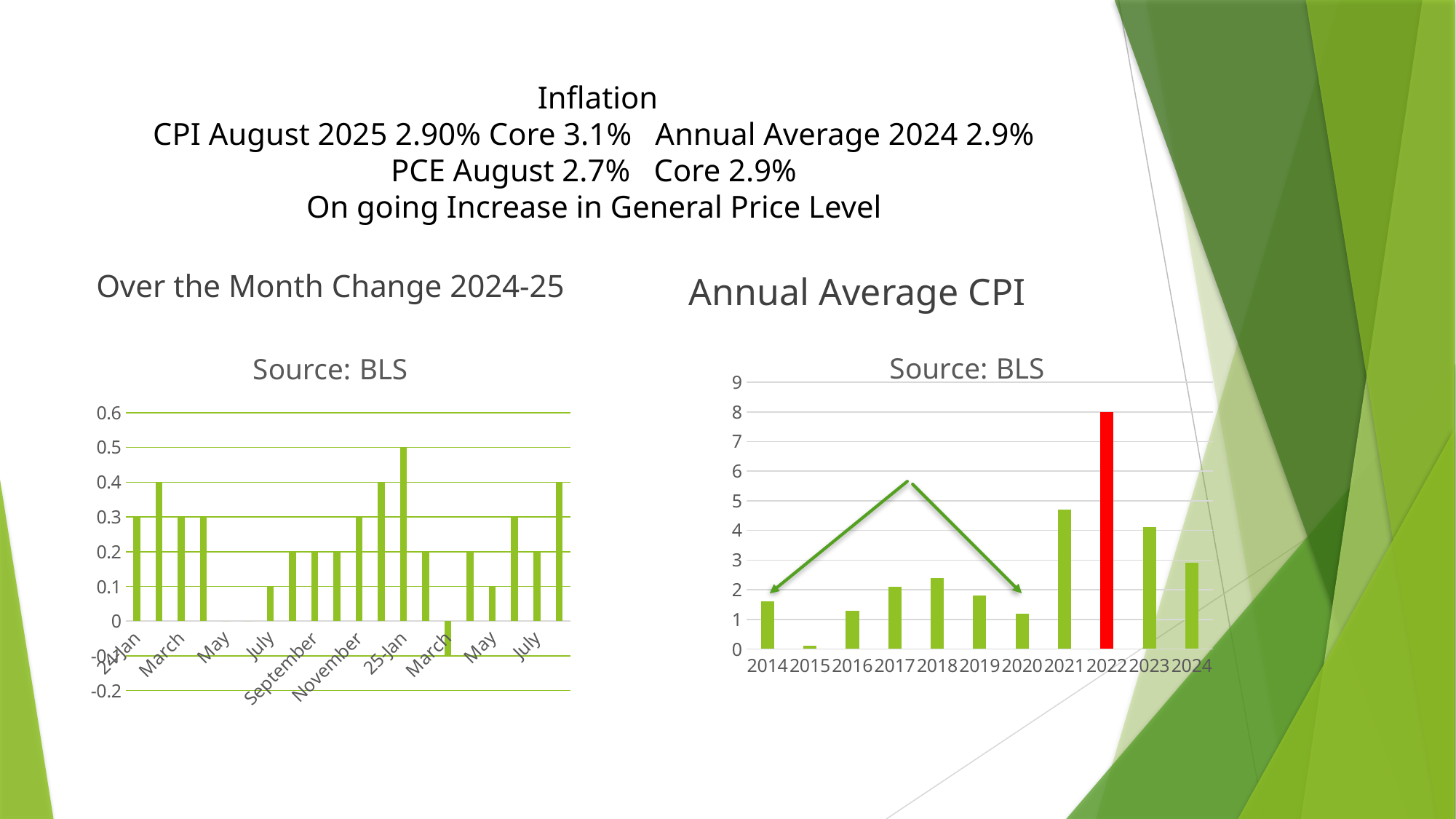
In the 'Over the Month Change 2024-25' chart, which month has the highest value? 25-Jan How many years are shown on the x axis of the 'Annual Average CPI' chart? 11 In the 'Annual Average CPI' chart, is the value for 2021 greater or less than 4? greater In the 'Annual Average CPI' chart, which bar is coloured red? 2022 In the 'Annual Average CPI' chart, which year has the highest value? 2022 In the 'Over the Month Change 2024-25' chart, what is the value for 25-Jan? 0.5 In the 'Annual Average CPI' chart, which year has the lowest value? 2015 In the 'Over the Month Change 2024-25' chart, which is larger, the value for 24-Jan or the value for 25-Jan? 25-Jan In the 'Annual Average CPI' chart, which is larger, the value for 2021 or the value for 2023? 2021 In the 'Annual Average CPI' chart, what is the value for 2022? 8 What kind of chart is the 'Annual Average CPI' chart on the right? bar chart In the 'Annual Average CPI' chart, is the value for 2015 greater or less than 1? less